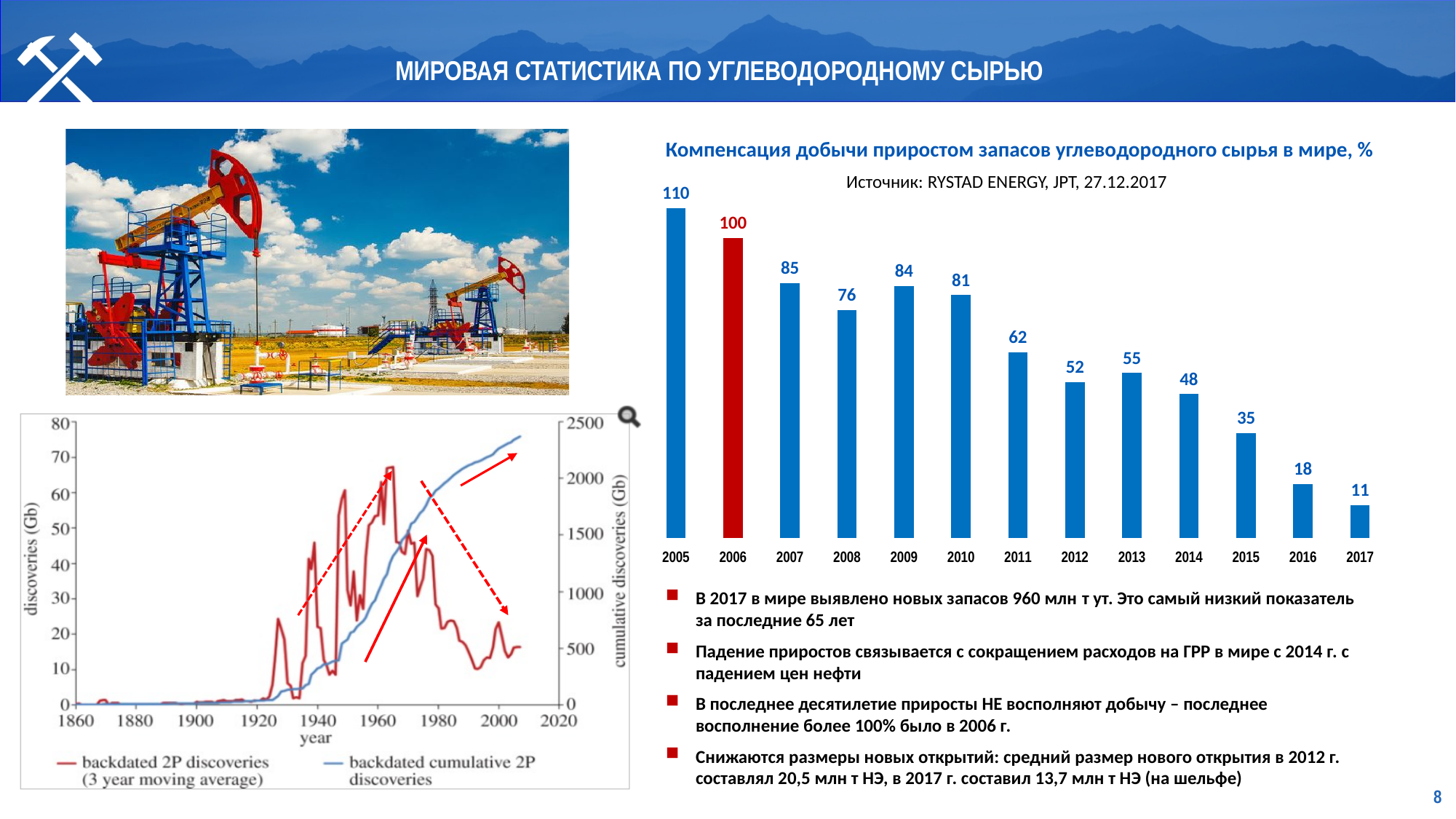
On the bar chart 'Компенсация добычи приростом запасов углеводородного сырья в мире, %', do the values generally rise or fall from 2005 to 2017? fall On the bar chart 'Компенсация добычи приростом запасов углеводородного сырья в мире, %', what is the value for 2012? 52 On the bar chart 'Компенсация добычи приростом запасов углеводородного сырья в мире, %', which year has the highest value? 2005 On the bar chart 'Компенсация добычи приростом запасов углеводородного сырья в мире, %', what is the difference between the values for 2006 and 2017? 89 On the bar chart 'Компенсация добычи приростом запасов углеводородного сырья в мире, %', what is the value for 2005? 110 How many series does the legend of the bottom-left line chart list? 2 On the bar chart 'Компенсация добычи приростом запасов углеводородного сырья в мире, %', which year has the lowest value? 2017 On the bar chart 'Компенсация добычи приростом запасов углеводородного сырья в мире, %', which is larger, the value for 2009 or the value for 2010? 2009 On the bar chart 'Компенсация добычи приростом запасов углеводородного сырья в мире, %', which year's bar is coloured red? 2006 On the bar chart 'Компенсация добычи приростом запасов углеводородного сырья в мире, %', how many years are shown? 13 What kind of chart is the chart in the bottom-left of the slide? line chart On the bottom-left line chart, is the value of backdated cumulative 2P discoveries in 2000 greater or less than 1500 Gb? greater